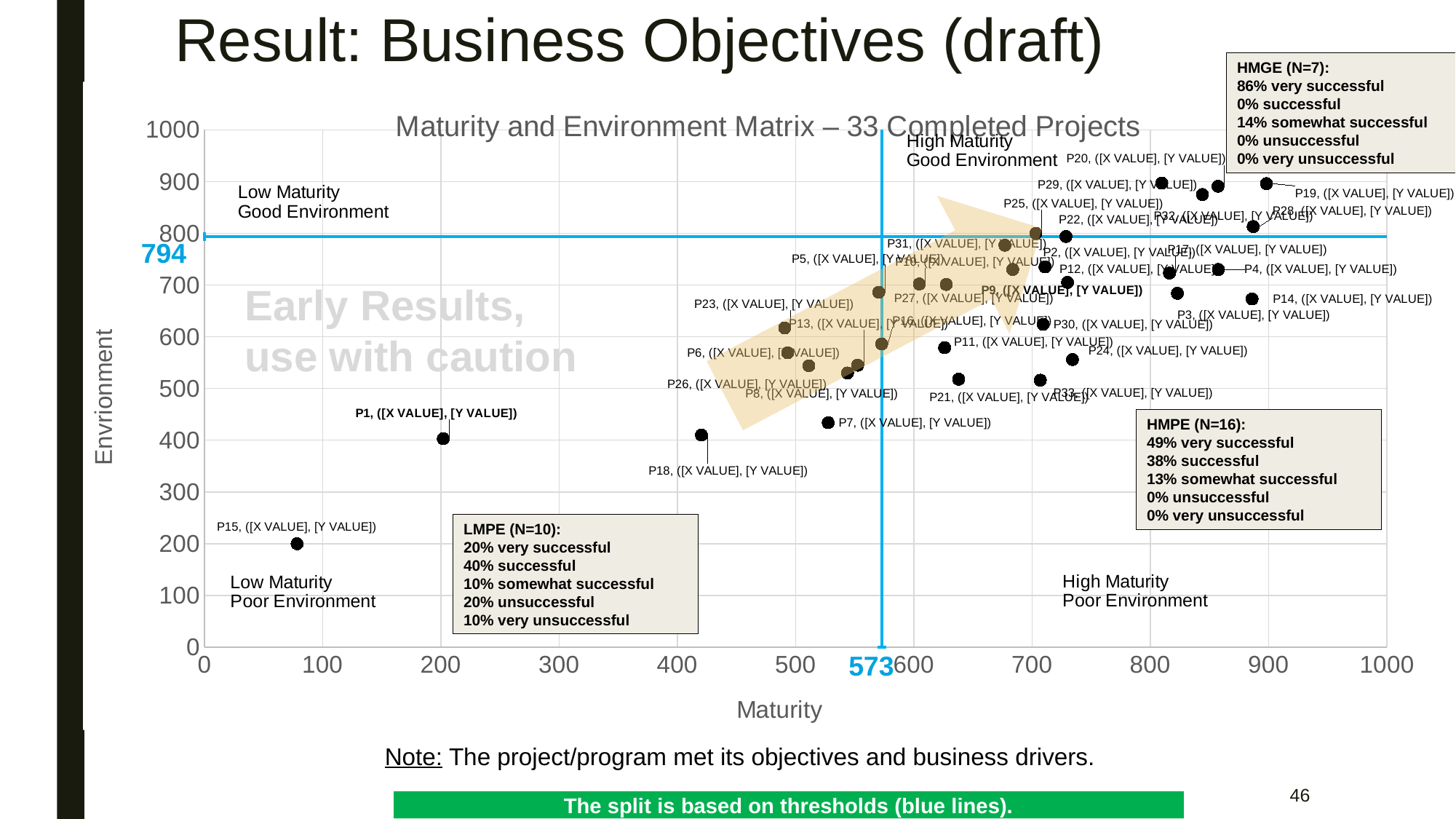
Is the Maturity value for P19 greater or less than 800? greater What kind of chart is shown on the slide? scatter chart How many completed projects does the chart title say are plotted? 33 Is the Environment value for P15 greater or less than 300? less Which project has the lowest Maturity value on the chart? P15 What is the label of the horizontal axis of the chart? Maturity What is the title of the chart? Maturity and Environment Matrix – 33 Completed Projects Is the Maturity value for P1 greater or less than 300? less Which project has the lowest Environment value on the chart? P15 Which project has the higher Environment value, P1 or P15? P1